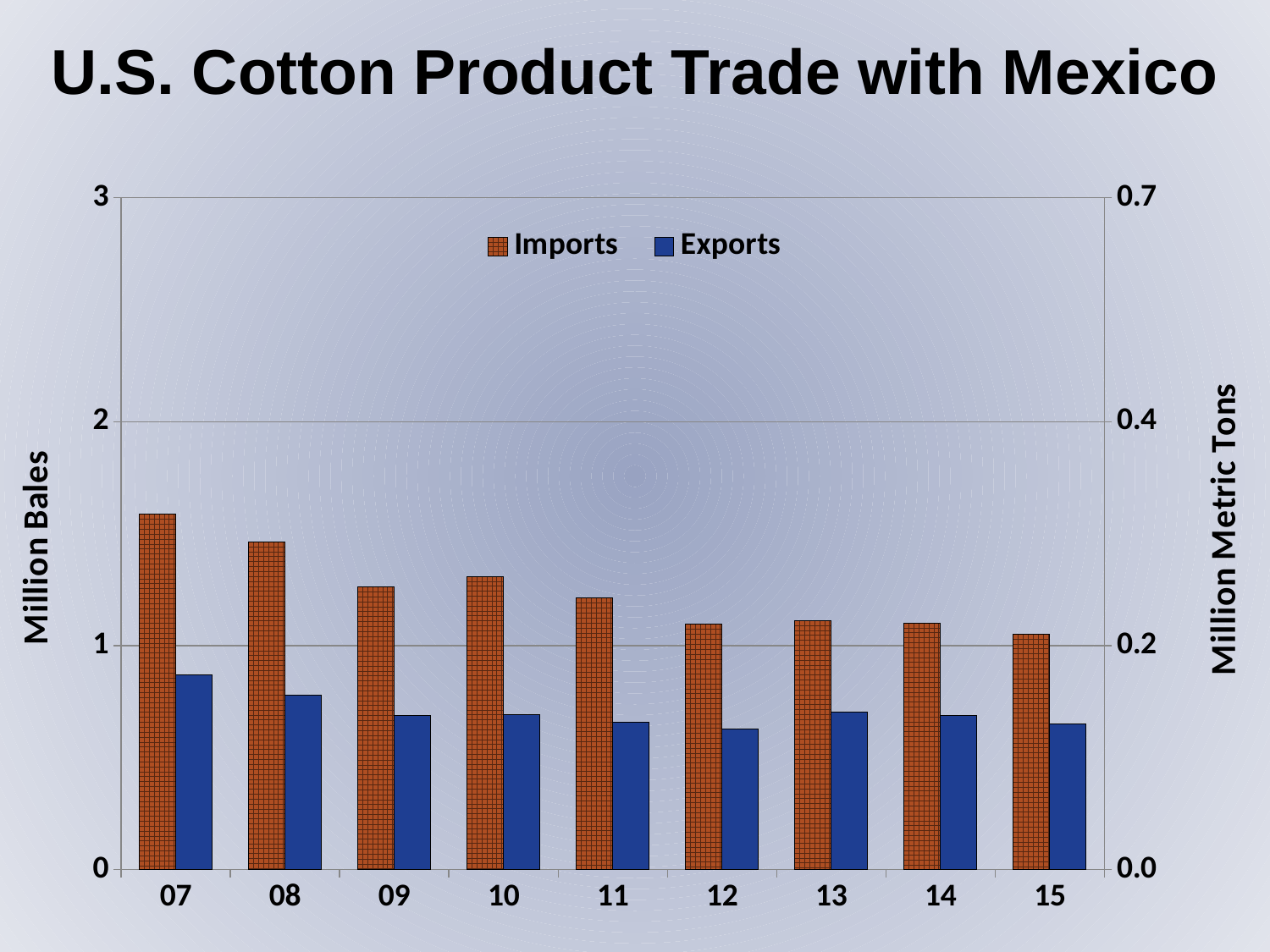
Is the Exports value for 07 greater or less than 1 million bales? less Which is larger in 07, Imports or Exports? Imports Which year has the highest Imports value? 07 How many series does the legend list? 2 Is the Imports value for 08 greater or less than 1 million bales? greater Do Imports generally rise or fall from 07 to 15? fall Is the Imports value for 07 greater or less than 2 million bales? less What is the label on the left vertical axis? Million Bales What kind of chart is shown on the slide? bar chart How many years are shown on the x axis? 9 Which year has the highest Exports value? 07 Which year has the larger Imports value, 07 or 08? 07